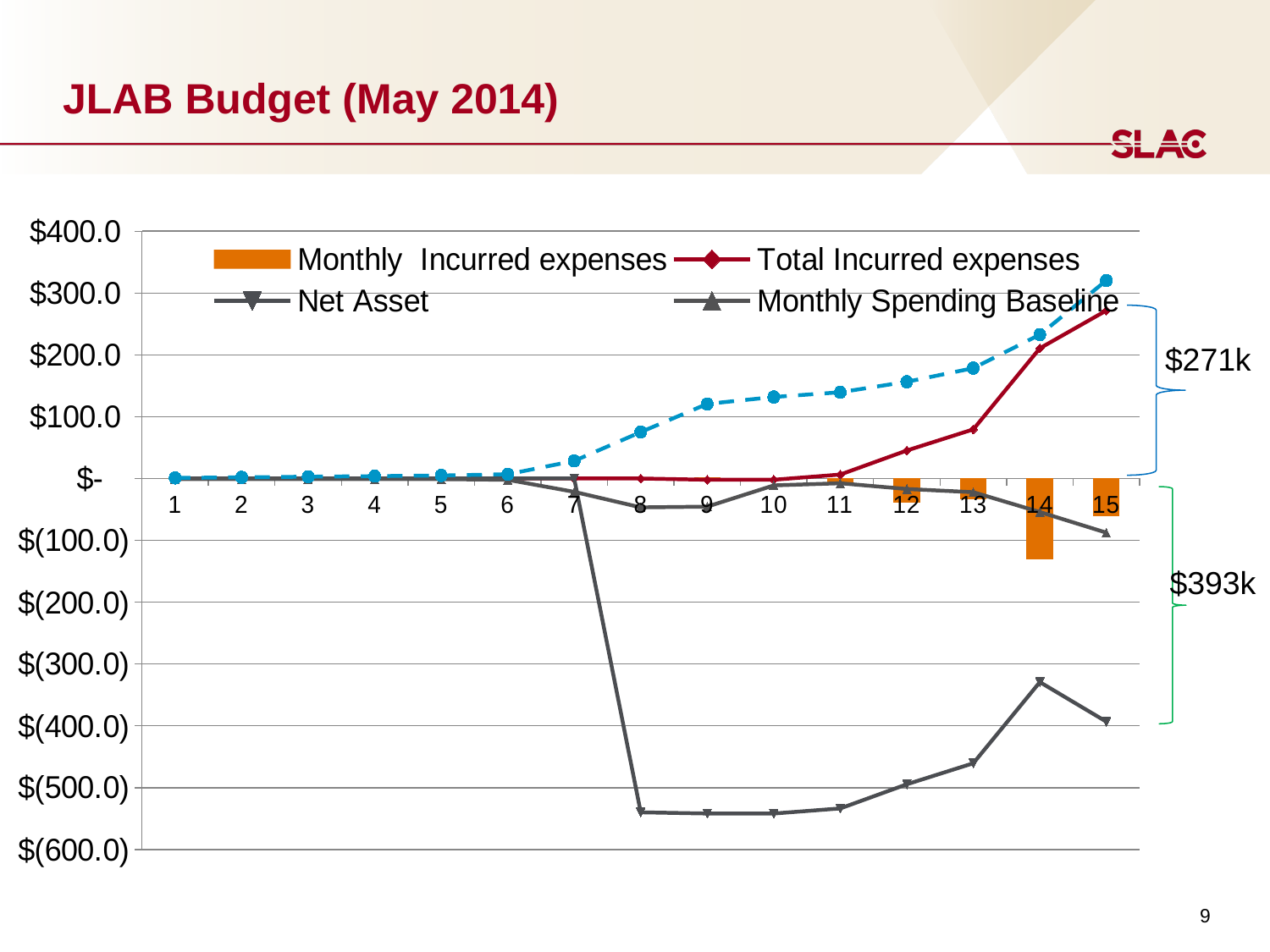
Is the Net Asset value at point 8 greater or less than $(500.0)? less Is the Total Incurred expenses value at point 15 greater or less than $200.0? greater At which point is the Monthly Incurred expenses bar the largest? 14 How many series does the chart legend list? 4 Does the Total Incurred expenses line rise or fall from point 7 to point 15? rise What value is annotated next to the lower bracket on the right side of the chart? $393k Is the Total Incurred expenses value at point 13 greater or less than $100.0? less What value is annotated next to the upper bracket on the right side of the chart? $271k Which is higher, the Net Asset value at point 14 or at point 15? Point 14 What kind of chart is shown on the slide? A combination bar and line chart How many points are shown along the x axis? 15